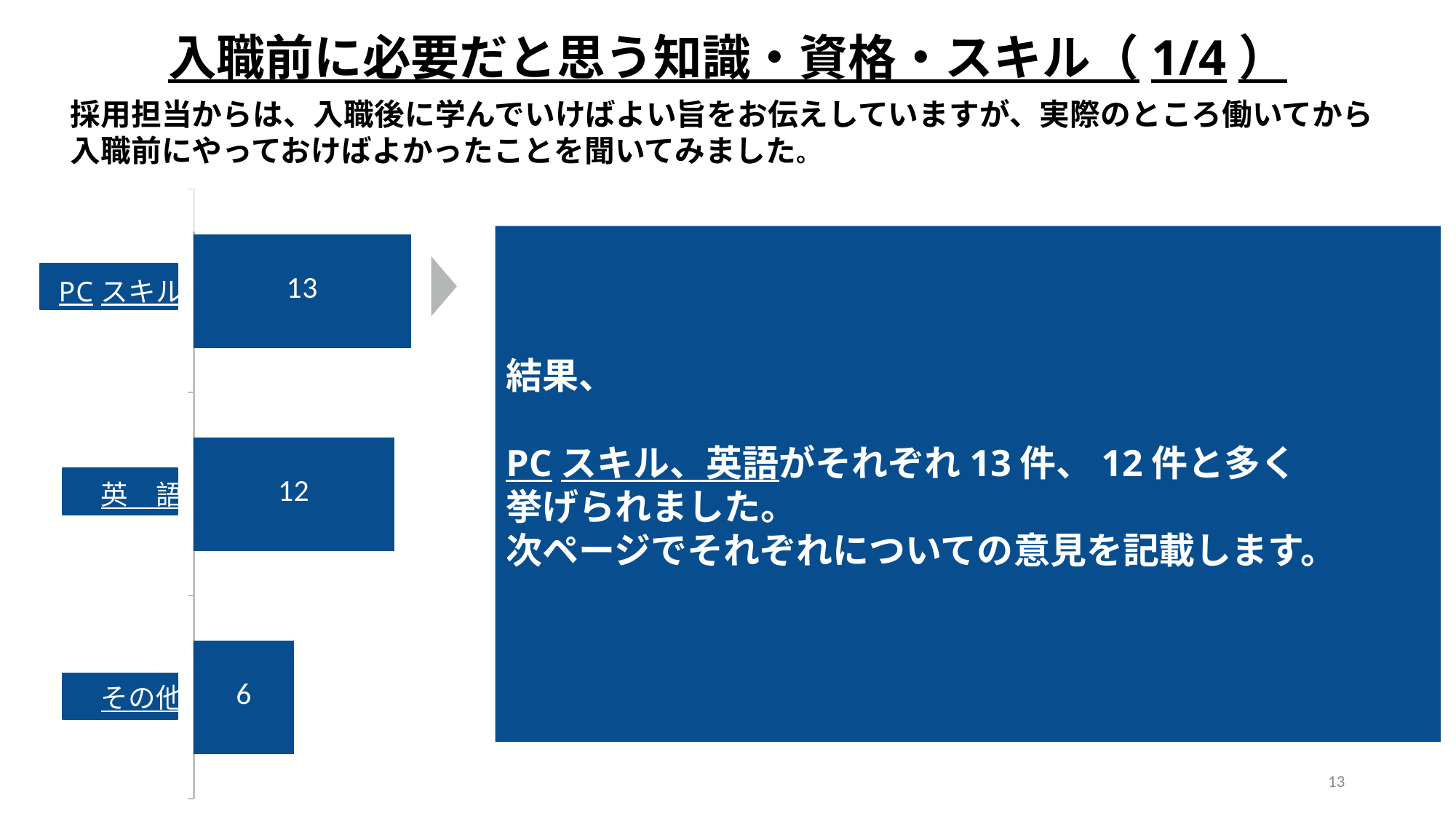
What is the total of all three values in the chart? 31 What is the value for PC スキル? 13 Which category has the lowest value? その他 What kind of chart is shown on the slide? bar chart Which category has the highest value? PC スキル What is the difference between the values for 英語 and その他? 6 What colour are the bars in the chart? dark blue What is the value for その他? 6 What is the difference between the values for PC スキル and その他? 7 Which is larger, the value for 英語 or the value for その他? 英語 How many categories are shown in the chart? 3 What is the value for 英語? 12